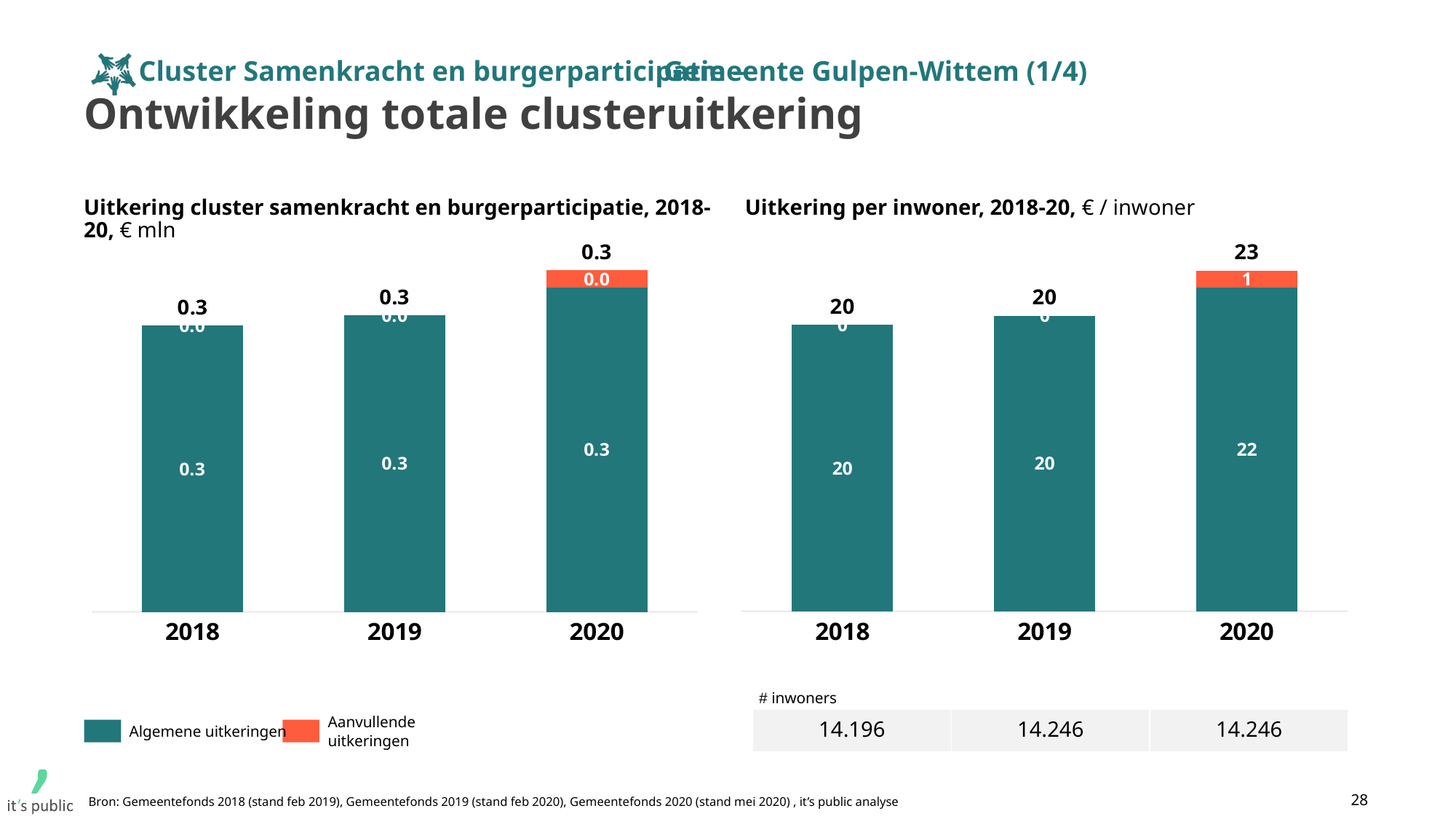
What kind of chart is the 'Uitkering per inwoner' chart? Stacked bar chart In the 'Uitkering cluster samenkracht en burgerparticipatie' chart, what is the value of Algemene uitkeringen for 2019? 0.3 In the 'Uitkering per inwoner' chart, what is the total value for 2020? 23 In the 'Uitkering per inwoner' chart, what is the value of Algemene uitkeringen for 2020? 22 In the 'Uitkering per inwoner' chart, what is the difference between the total for 2020 and the total for 2019? 3 Which series is shown in orange in the legend? Aanvullende uitkeringen In the 'Uitkering cluster samenkracht en burgerparticipatie' chart, what is the total value for 2020? 0.3 In the 'Uitkering per inwoner' chart, what is the total value for 2018? 20 In the 'Uitkering per inwoner' chart, what is the value of Aanvullende uitkeringen for 2020? 1 How many years are shown on the x axis of the 'Uitkering per inwoner' chart? 3 How many series does the legend list for the charts on this slide? 2 In the 'Uitkering per inwoner' chart, which year has the highest total? 2020